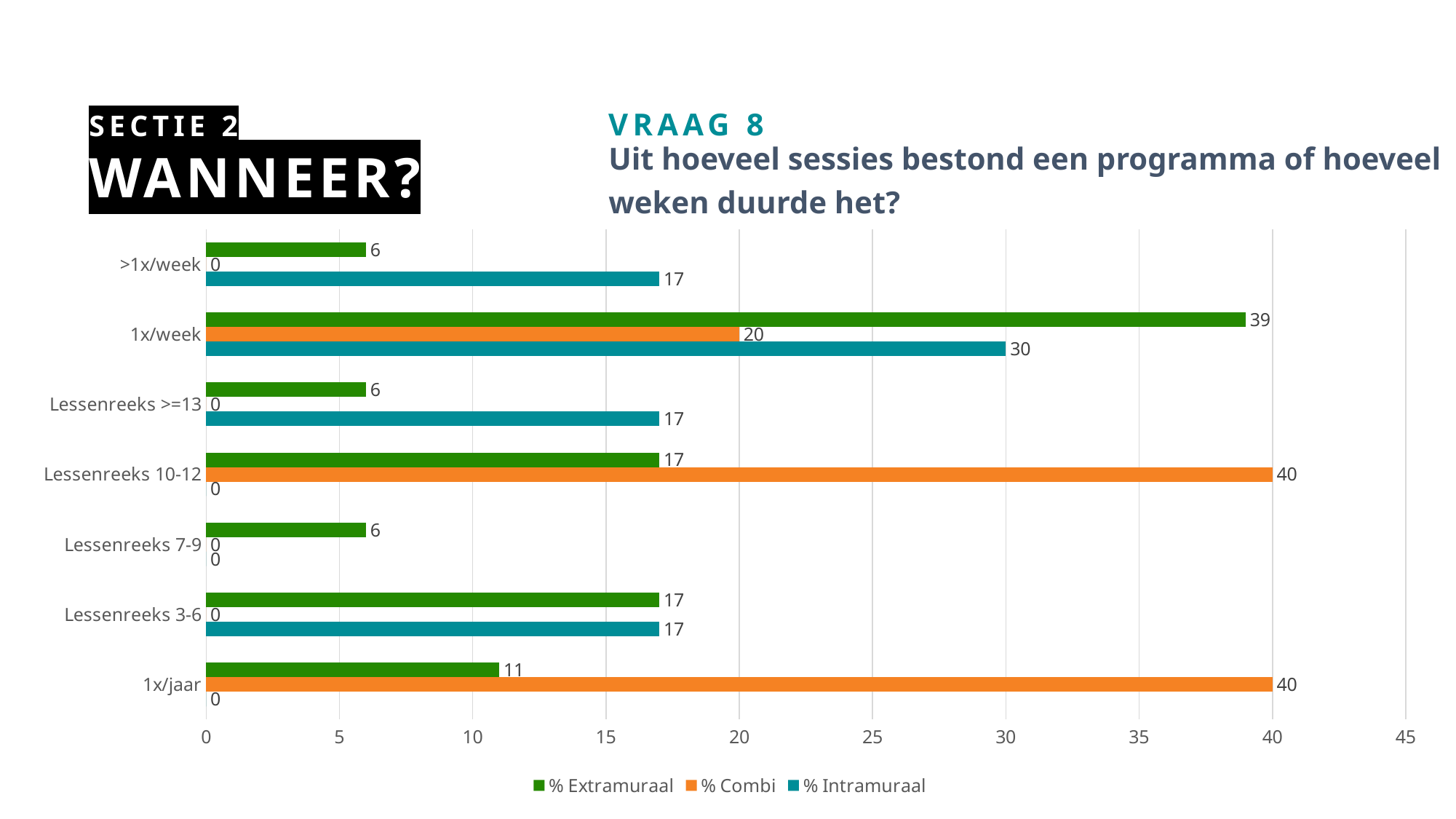
How many series does the legend list? 3 How many categories are shown on the chart? 7 Which is larger for Lessenreeks 10-12: % Extramuraal or % Combi? % Combi Which category has the highest % Extramuraal value? 1x/week Which category has the highest % Intramuraal value? 1x/week What is the difference between the % Extramuraal and % Intramuraal values for 1x/week? 9 What is the % Extramuraal value for 1x/jaar? 11 Which series is shown in orange? % Combi What is the % Intramuraal value for 1x/week? 30 What is the % Combi value for Lessenreeks 10-12? 40 What is the % Extramuraal value for 1x/week? 39 What kind of chart is shown on the slide? Bar chart